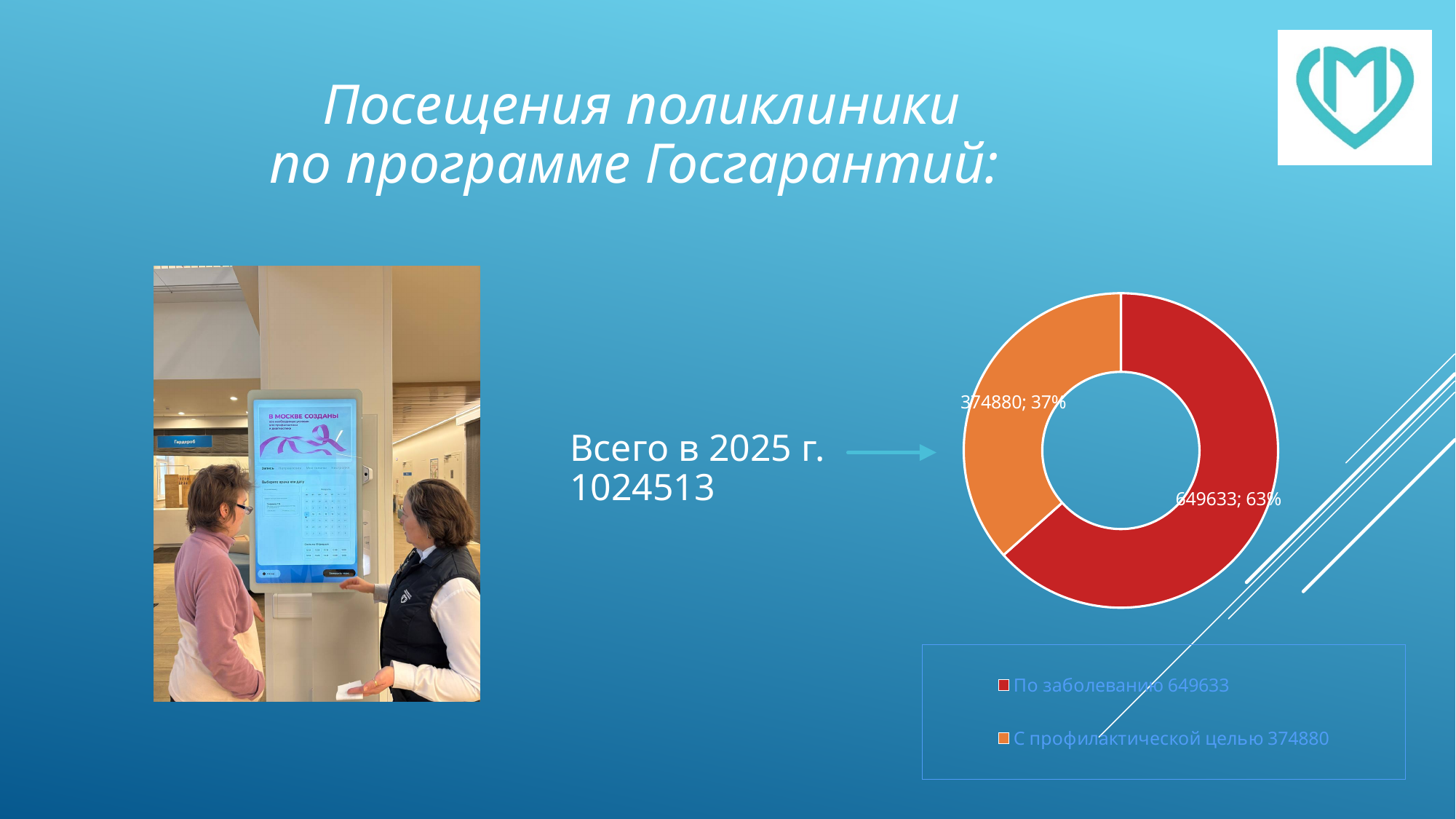
Which is larger: По заболеванию or С профилактической целью? По заболеванию What is the difference between the values for По заболеванию and С профилактической целью? 274753 Which category has the largest slice in the chart? По заболеванию Which category has the smallest slice in the chart? С профилактической целью What share of the chart does С профилактической целью represent? 37% What is the total of all visits shown in the chart for 2025? 1024513 How many categories are shown in the chart? 2 What share of the chart does По заболеванию represent? 63% What is the value for По заболеванию in the chart? 649633 What colour is the slice for По заболеванию? red What is the value for С профилактической целью in the chart? 374880 What kind of chart is shown on the slide? doughnut chart